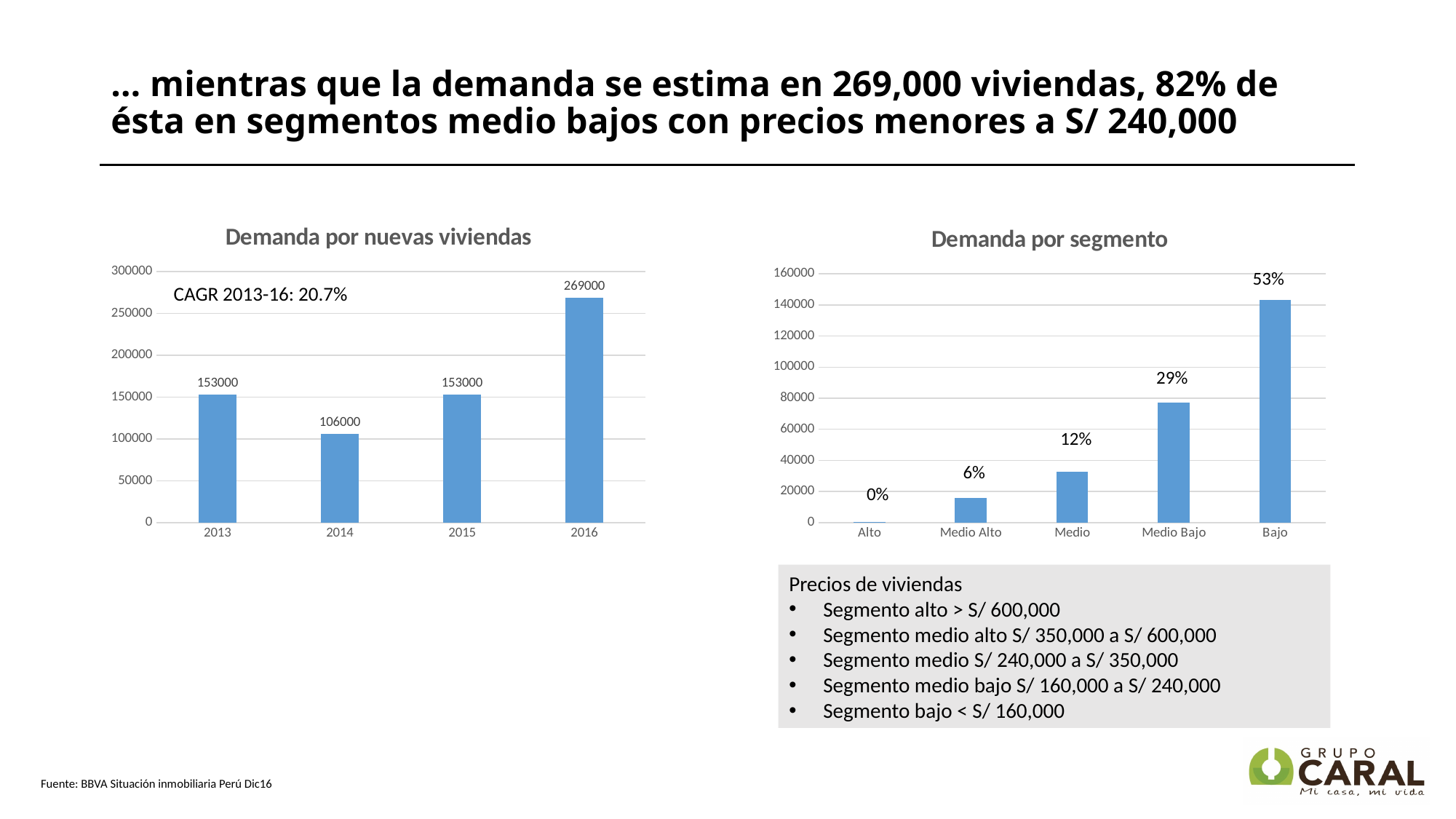
In the 'Demanda por nuevas viviendas' chart, what is the difference between the 2016 and 2015 values? 116000 In the 'Demanda por nuevas viviendas' chart, what is the value for 2014? 106000 In the 'Demanda por nuevas viviendas' chart, how many years are shown on the x axis? 4 In the 'Demanda por nuevas viviendas' chart, what is the value for 2016? 269000 In the 'Demanda por nuevas viviendas' chart, which year has the lowest value? 2014 In the 'Demanda por nuevas viviendas' chart, which year has the highest value? 2016 What kind of chart is 'Demanda por segmento'? Bar chart In the 'Demanda por segmento' chart, what percentage label is shown for the Medio Bajo segment? 29% In the 'Demanda por segmento' chart, which segment has the highest bar? Bajo In the 'Demanda por segmento' chart, is the value for Medio Alto greater or less than 20000? less In the 'Demanda por segmento' chart, is the value for Bajo greater or less than 120000? greater In the 'Demanda por segmento' chart, what percentage label is shown for the Medio segment? 12%